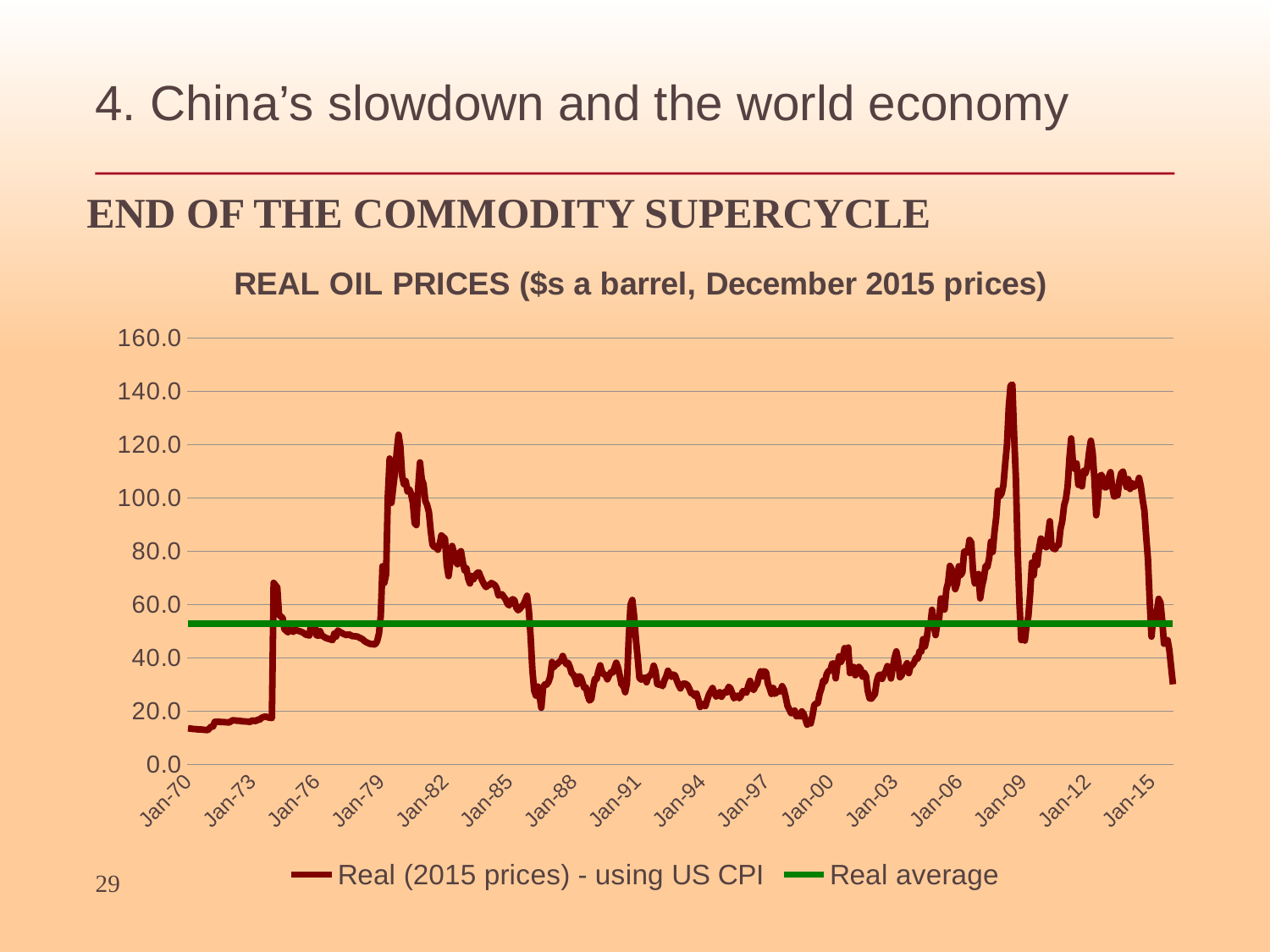
What is the title of the chart? REAL OIL PRICES ($s a barrel, December 2015 prices) How many series does the legend list? 2 Between Jan-82 and Jan-85, does the real oil price generally rise or fall? fall Which is higher, the peak in real oil prices around 1980 or the peak around 2008? the peak around 2008 Between Jan-03 and Jan-06, does the real oil price generally rise or fall? rise Is the value of the real oil price at Jan-70 greater or less than 20.0? less Is the real oil price at Jan-12 greater or less than 100.0? greater Is the Real average line greater or less than 40.0? greater What kind of chart is shown on the slide? line chart What are the two entries in the chart's legend? Real (2015 prices) - using US CPI; Real average